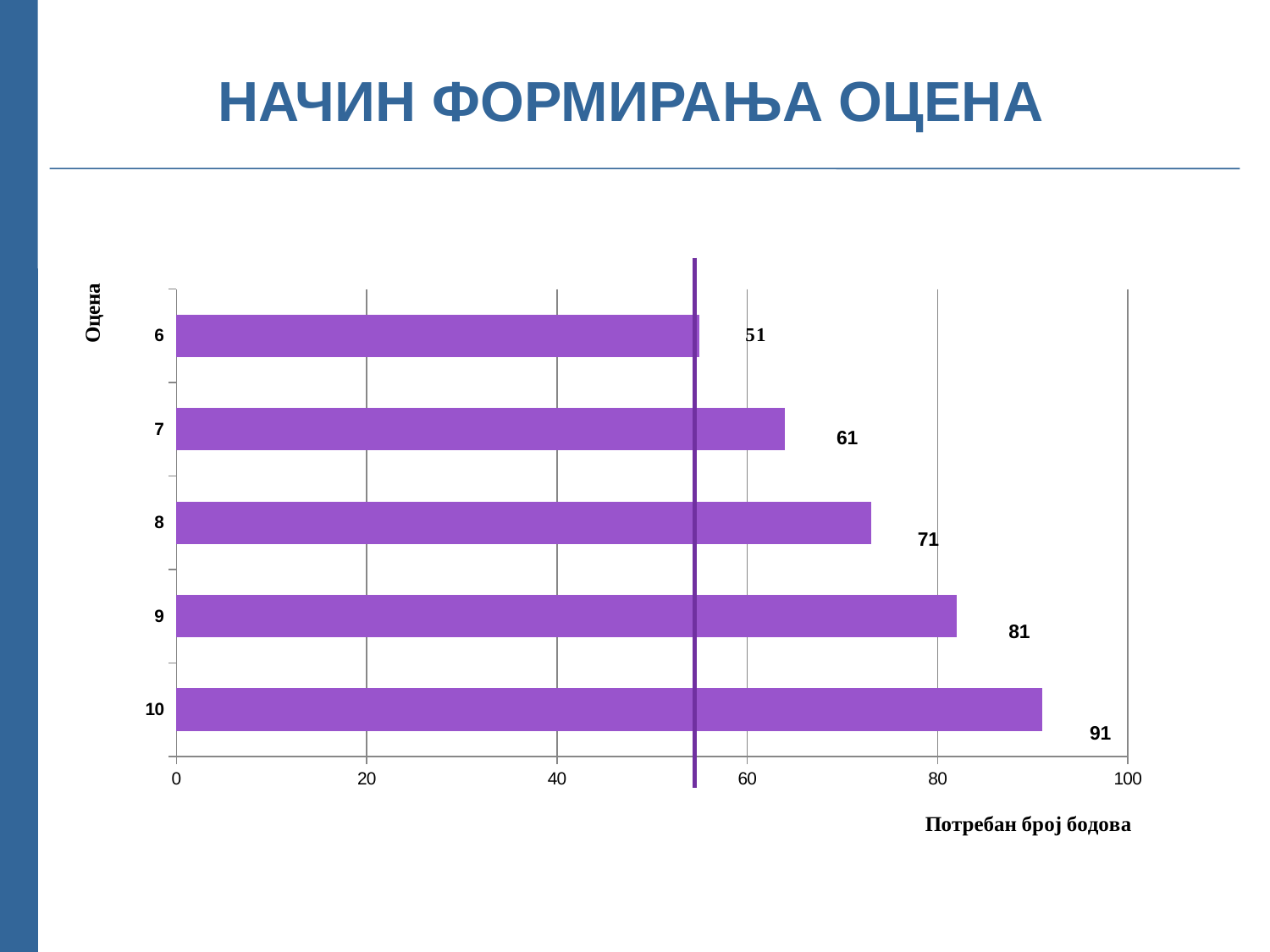
What type of chart is shown on the slide? bar chart Which grade requires the highest number of points? 10 What is the difference between the points required for grade 9 and grade 7? 20 Which grade requires the lowest number of points? 6 How many grade categories are plotted in the chart? 5 Do the required points increase or decrease as the grade goes from 6 to 10? increase What is the required number of points for grade 8? 71 What is the required number of points (Потребан број бодова) for grade 6? 51 Is the value for grade 9 greater or less than 60? greater Which requires more points, grade 8 or grade 7? grade 8 What is the required number of points for grade 10? 91 What is the label of the horizontal axis of the chart? Потребан број бодова